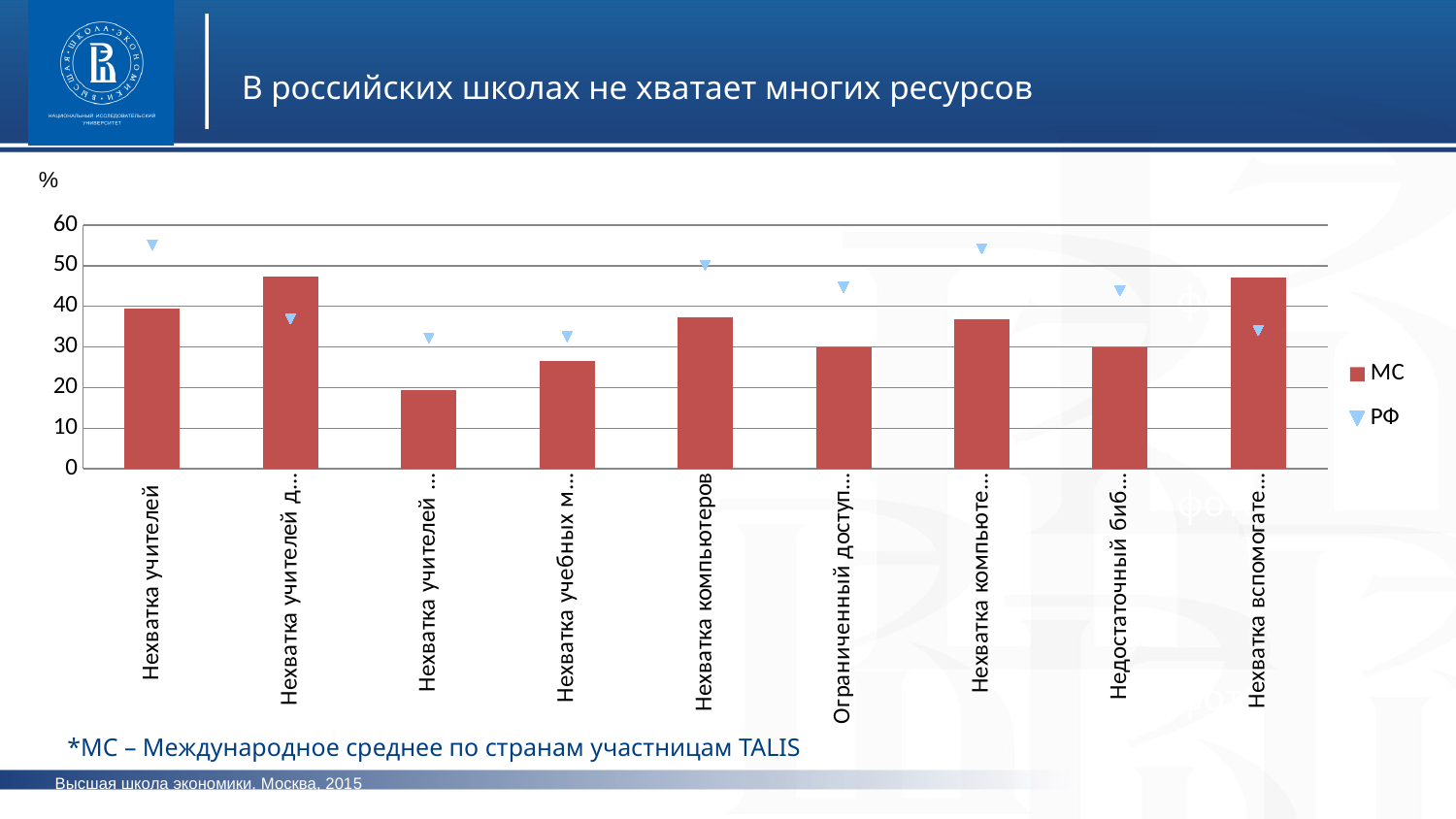
What unit is shown at the top of the y axis of the chart? % What are the two series named in the chart legend? МС and РФ For "Нехватка компьютеров", which series has the larger value, МС or РФ? РФ How many series does the chart legend list? 2 Is the РФ value for "Нехватка учителей" greater or less than 50? greater What kind of chart is shown on the slide? bar chart For "Нехватка учителей", which series has the larger value, МС or РФ? РФ Is the МС value for "Нехватка учителей" greater or less than 30? greater Is the МС value for "Нехватка компьютеров" greater or less than 40? less How many categories are plotted along the x axis of the chart? 9